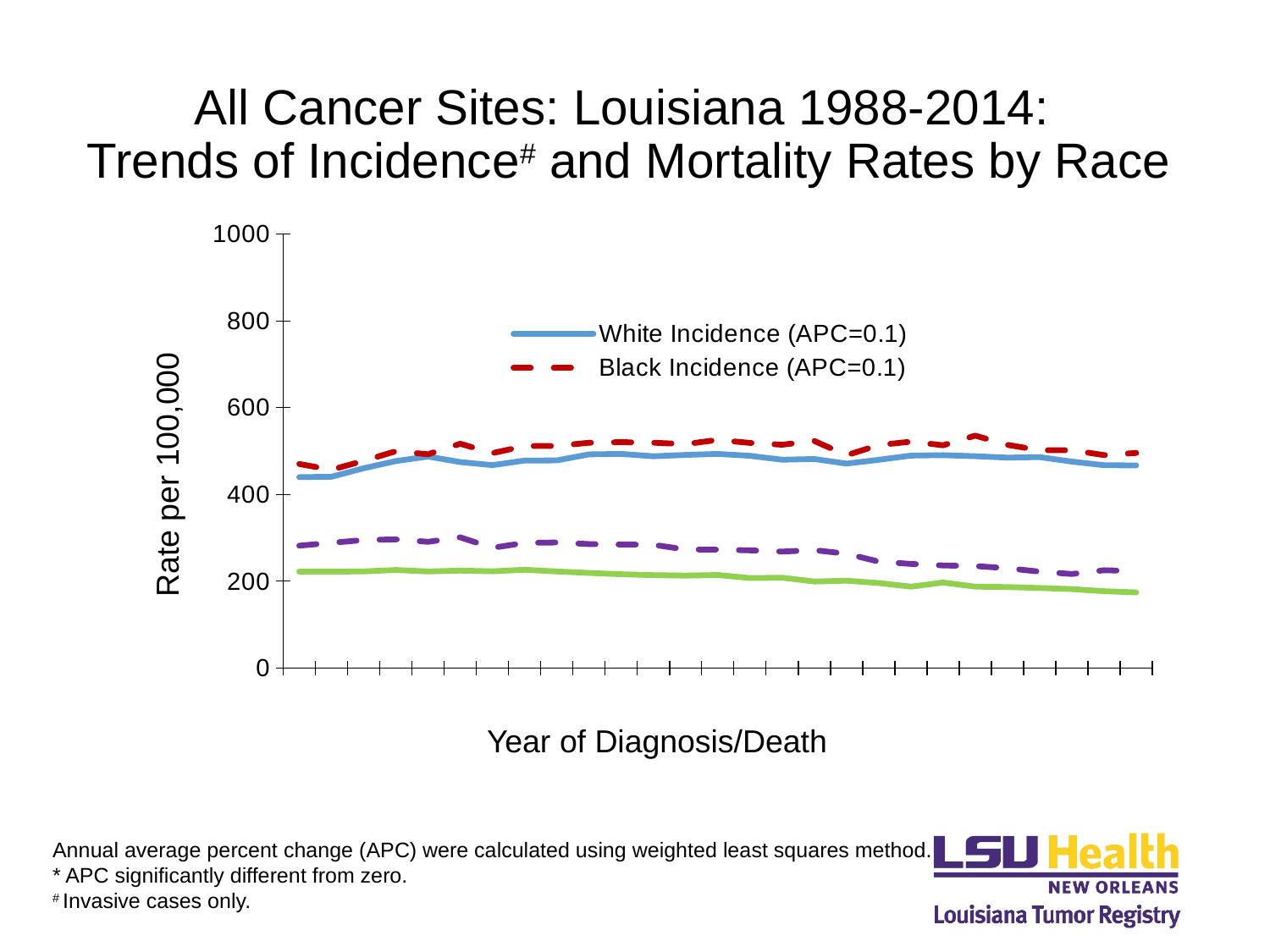
Does the purple dashed line rise or fall along the x axis? fall What kind of chart is shown on the slide? line chart Which series is higher throughout the chart, White Incidence or Black Incidence? Black Incidence Is the value for White Incidence greater or less than 400 across the years shown? greater Does the green solid line rise or fall along the x axis? fall What APC value is shown in the legend for White Incidence? APC=0.1 Is the value for Black Incidence greater or less than 400 across the years shown? greater How many series does the chart's legend list? 2 Is the value for White Incidence greater or less than 600 across the years shown? less What is the label of the y axis? Rate per 100,000